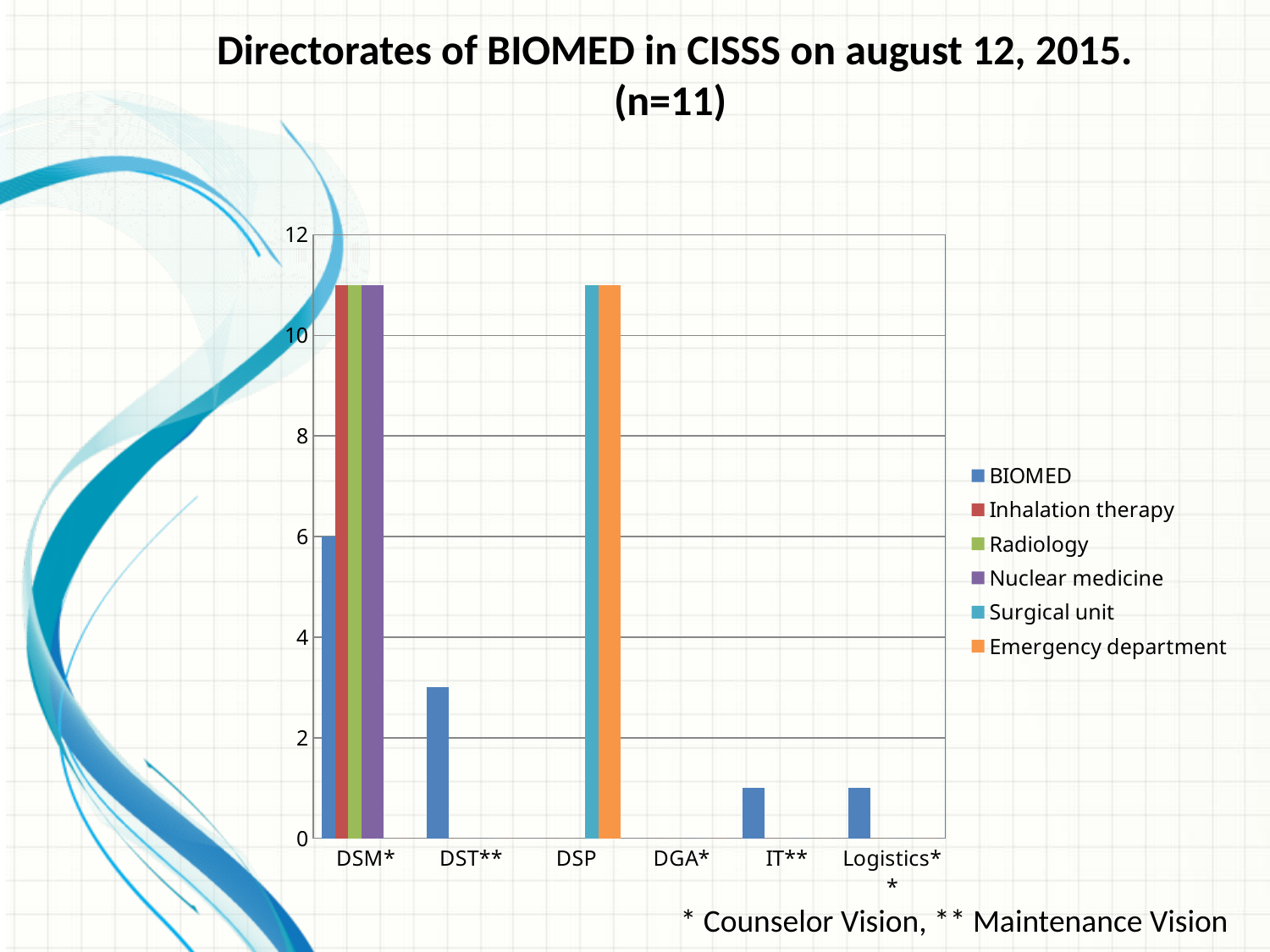
What is the BIOMED value for DSM*? 6 Which category has no bars plotted at all? DGA* Which is larger, the BIOMED value for DSM* or the BIOMED value for DST**? DSM* Is the BIOMED value for DST** greater or less than 4? less Is the Surgical unit value for DSP greater or less than 10? greater Which series is shown in orange in the legend? Emergency department What kind of chart is shown on the slide? bar chart Is the Inhalation therapy value for DSM* greater or less than 10? greater How many categories are shown on the x axis? 6 How many series does the legend list? 6 Which category has the highest BIOMED value? DSM*